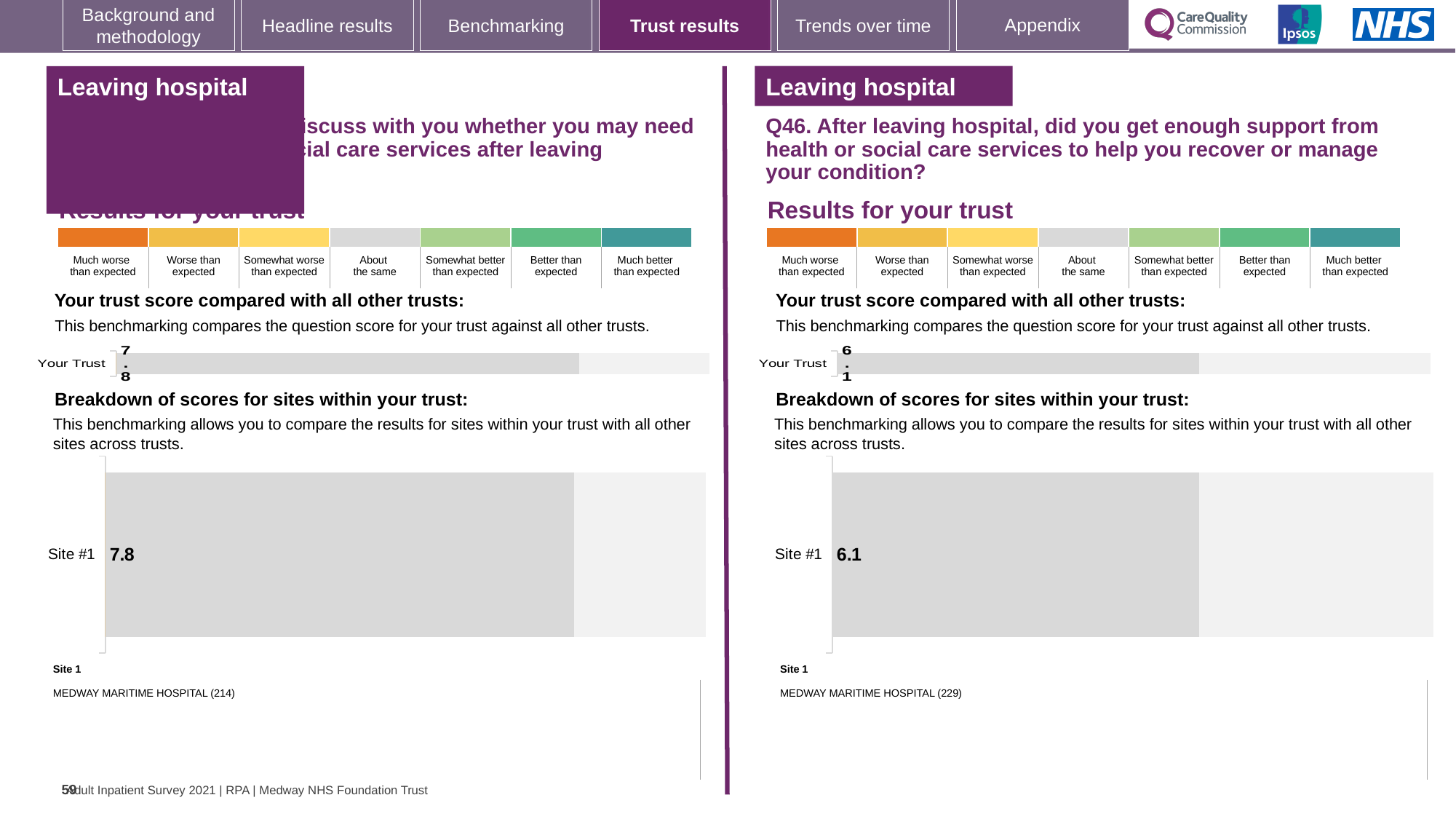
What is the difference between the Site #1 score on the left-hand chart and the Site #1 score on the right-hand chart (Q46)? 1.7 How many sites are shown in the breakdown of scores for sites within your trust on the left-hand chart? 1 On the left-hand chart, what is the score for Site #1 in the breakdown of scores for sites within your trust? 7.8 What kind of chart is used to show the breakdown of scores for sites within your trust on the right-hand side (Q46)? bar chart On the left-hand chart, what is the score shown for Your Trust? 7.8 How many rating categories are shown in the colour scale above the left-hand chart, from 'Much worse than expected' to 'Much better than expected'? 7 Which has the higher Site #1 score: the left-hand chart or the right-hand chart (Q46)? the left-hand chart How many sites are shown in the breakdown of scores for sites within your trust on the right-hand chart (Q46)? 1 On the right-hand chart (Q46), what is the score for Site #1 in the breakdown of scores for sites within your trust? 6.1 On the right-hand chart (Q46), which hospital is listed as Site 1? MEDWAY MARITIME HOSPITAL (229) On the right-hand chart (Q46), what is the score shown for Your Trust? 6.1